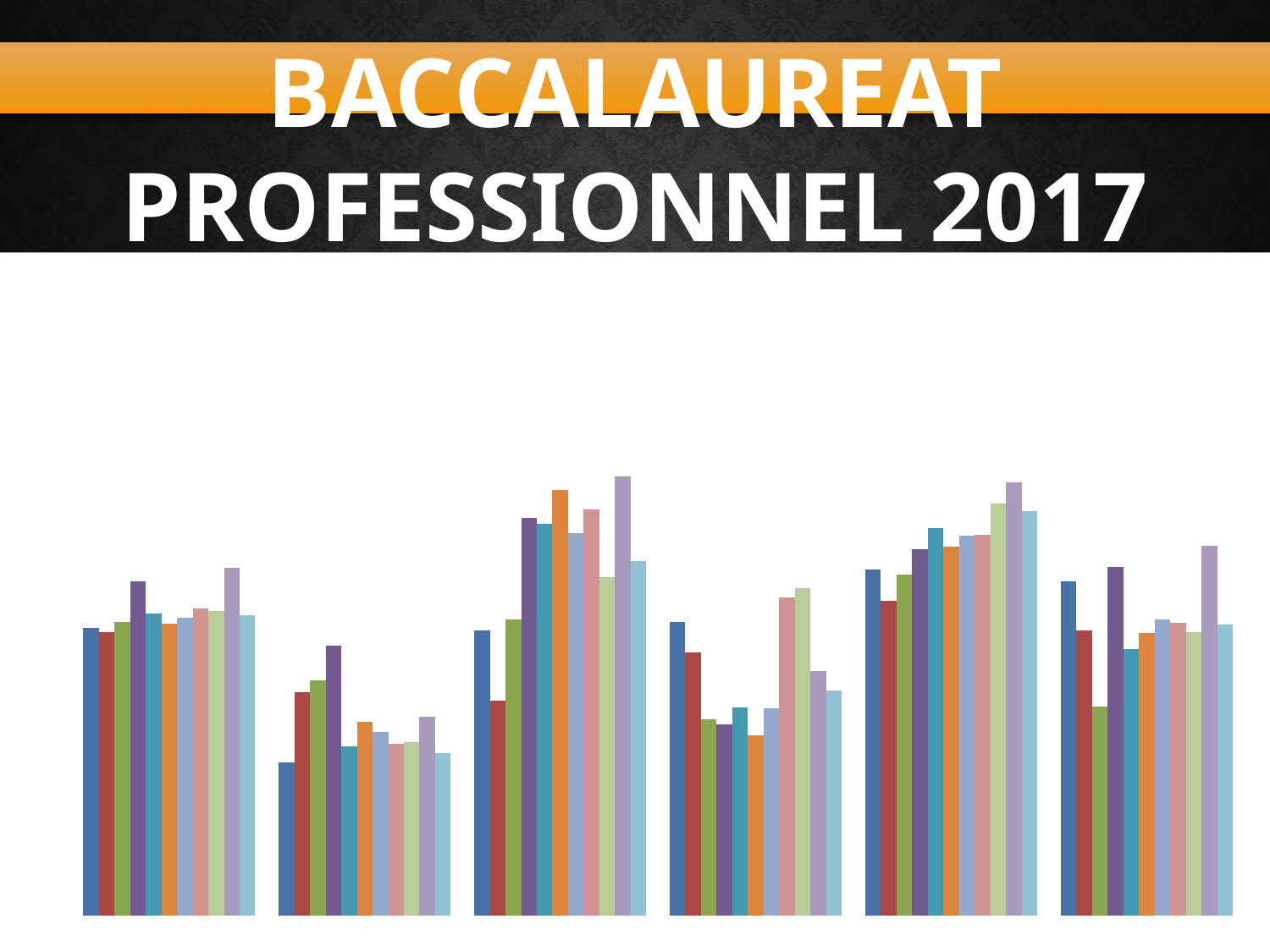
Which group of bars, counted from the left, contains the tallest bar on the chart? the third group What kind of chart is shown on the slide? bar chart Is the tallest bar in the third group from the left taller or shorter than the tallest bar in the first group from the left? taller Which group of bars, counted from the left, has the overall lowest bars on the chart? the second group How many groups of bars does the chart show? 6 Does the chart display a legend? No Does the chart show any axis labels or data labels? No How many bars are in each group of the chart? 11